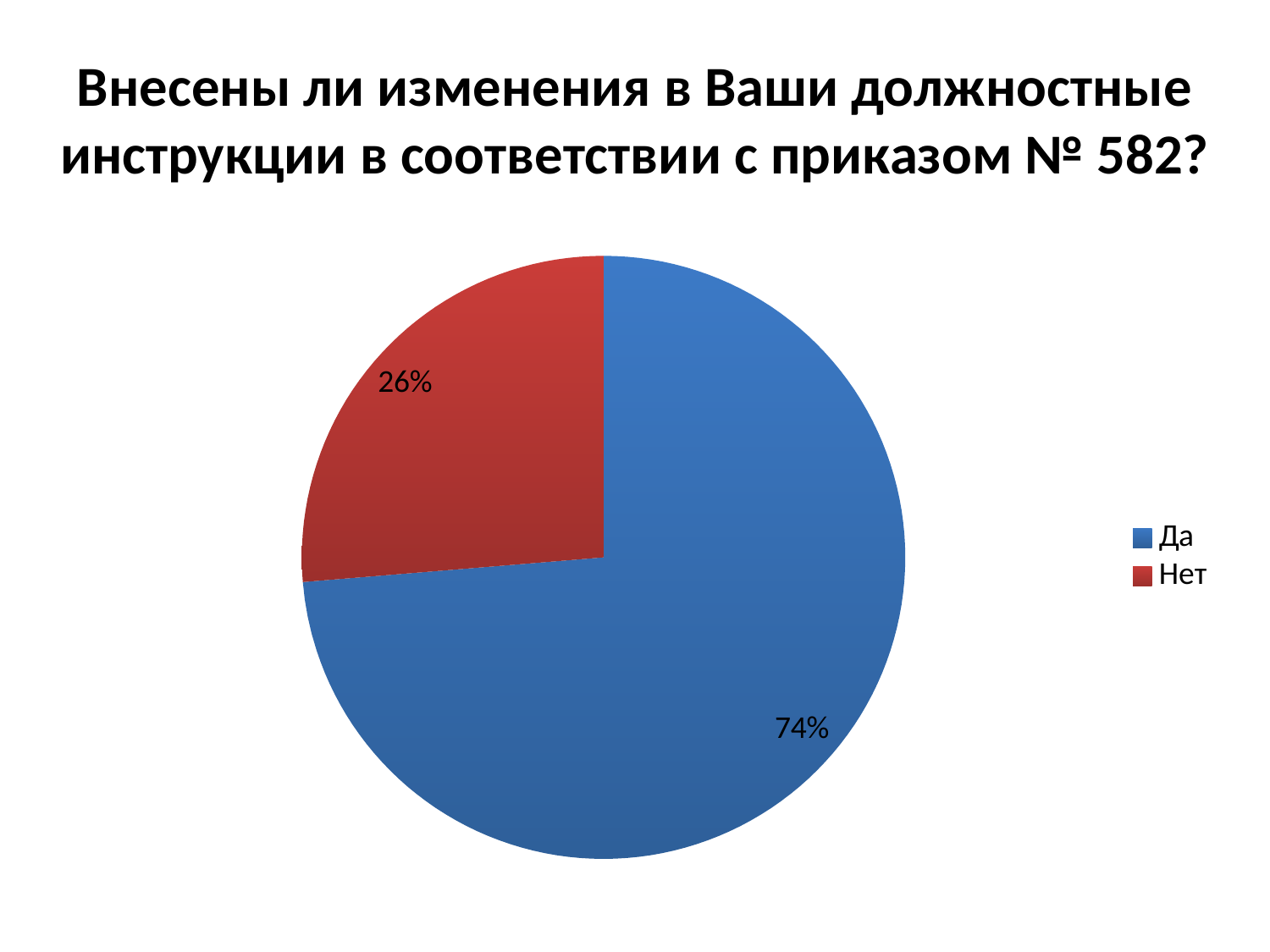
Which category has the largest slice of the pie? Да What is the difference in percentage points between the "Да" and "Нет" slices? 48 What share of the pie does the "Нет" slice represent? 26% What share of the pie does the "Да" slice represent? 74% Which slice is larger, "Да" or "Нет"? Да What kind of chart is shown on the slide? Pie chart How many entries does the legend list? 2 What is the title of the chart? Внесены ли изменения в Ваши должностные инструкции в соответствии с приказом № 582? How many slices does the pie chart have? 2 Which category has the smallest slice of the pie? Нет What colour is the "Нет" slice? Red